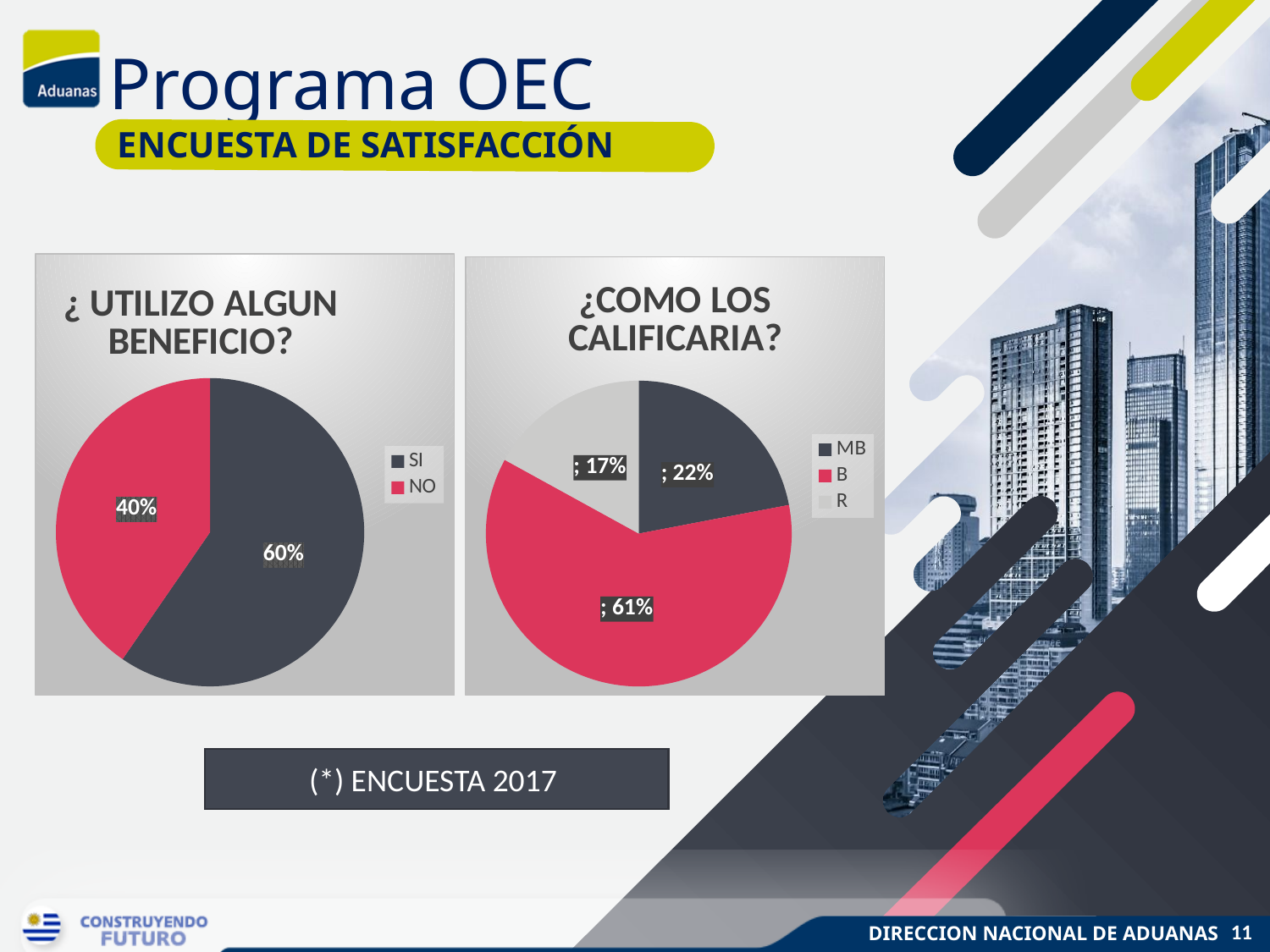
In the chart titled '¿COMO LOS CALIFICARIA?', which colour represents the category B? Red In the chart titled '¿COMO LOS CALIFICARIA?', how many categories does the legend list? 3 In the chart titled '¿COMO LOS CALIFICARIA?', what percentage is shown for R? 17% In the chart titled '¿ UTILIZO ALGUN BENEFICIO?', what percentage is shown for SI? 60% What kind of chart is the one titled '¿ UTILIZO ALGUN BENEFICIO?'? Pie chart In the chart titled '¿ UTILIZO ALGUN BENEFICIO?', what percentage is shown for NO? 40% In the chart titled '¿COMO LOS CALIFICARIA?', which category has the smallest share? R In the chart titled '¿COMO LOS CALIFICARIA?', what percentage is shown for B? 61% In the chart titled '¿COMO LOS CALIFICARIA?', what percentage is shown for MB? 22% In the chart titled '¿COMO LOS CALIFICARIA?', what is the difference in percentage points between B and MB? 39 In the chart titled '¿ UTILIZO ALGUN BENEFICIO?', what is the difference in percentage points between SI and NO? 20 In the chart titled '¿ UTILIZO ALGUN BENEFICIO?', which category has the larger share? SI